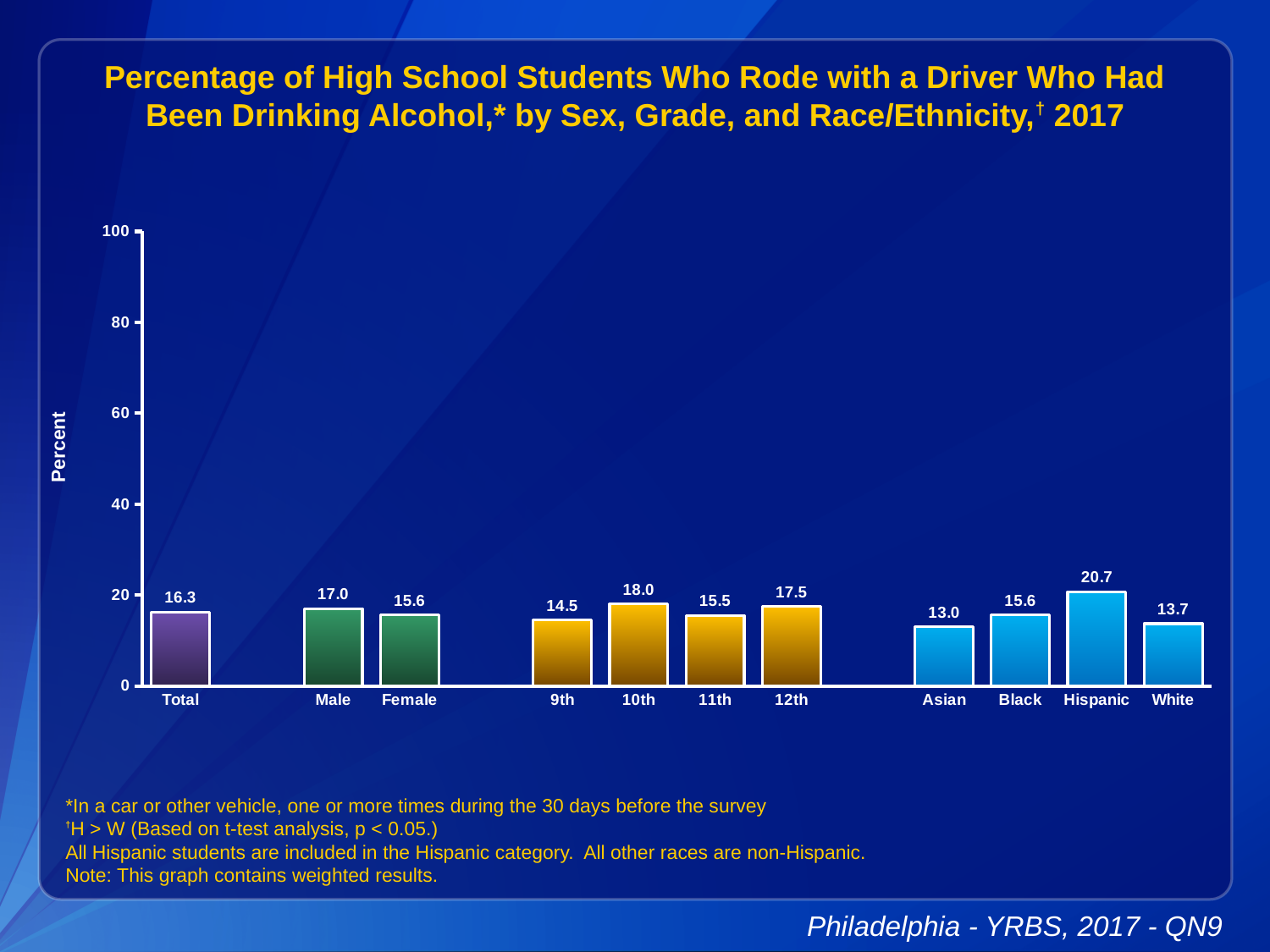
What is the difference between the values for Male and Female? 1.4 What is the value for 9th grade students? 14.5 What kind of chart is shown on the slide? bar chart Which category has the highest value? Hispanic How many categories are shown on the x axis? 11 Which category has the lowest value? Asian Is the value for Black students greater or less than 20? less What is the label of the y axis? Percent What is the value for Total? 16.3 What is the difference between the values for Hispanic and White students? 7.0 What is the value for Hispanic students? 20.7 Which is larger, the value for 10th grade or the value for 12th grade? 10th